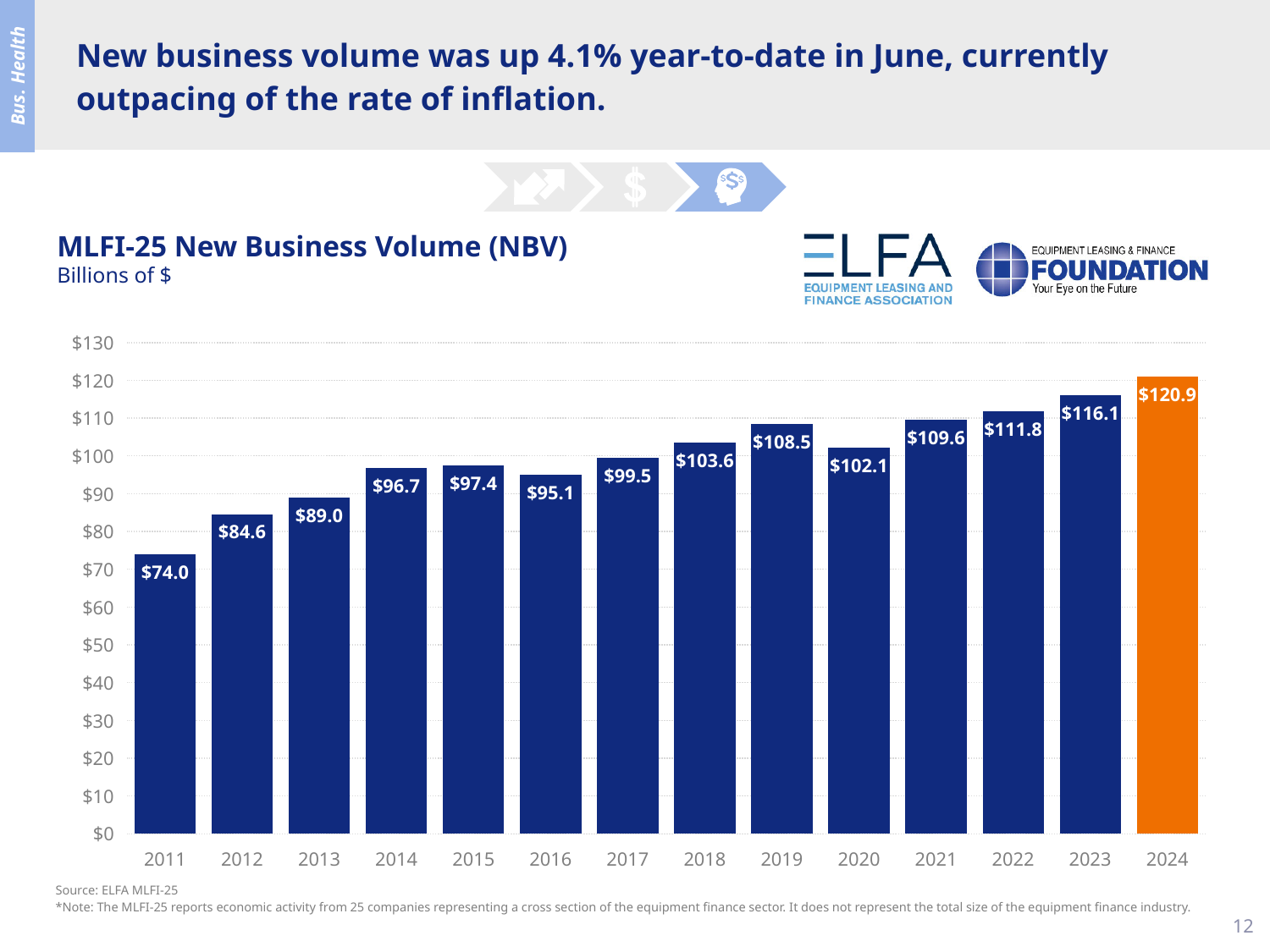
Which year has the highest MLFI-25 New Business Volume? 2024 What is the difference between the New Business Volume in 2024 and in 2023? $4.8 What is the MLFI-25 New Business Volume for 2011? $74.0 What is the MLFI-25 New Business Volume for 2024? $120.9 Does the New Business Volume generally rise or fall from 2011 to 2024? Rise What kind of chart is used to show MLFI-25 New Business Volume? Bar chart How many years are shown on the x axis of the chart? 14 Which year has a larger New Business Volume, 2015 or 2016? 2015 What unit is the MLFI-25 New Business Volume chart measured in, according to its subtitle? Billions of $ Is the New Business Volume for 2019 greater or less than $100? greater Which year has the lowest MLFI-25 New Business Volume? 2011 What is the MLFI-25 New Business Volume for 2020? $102.1